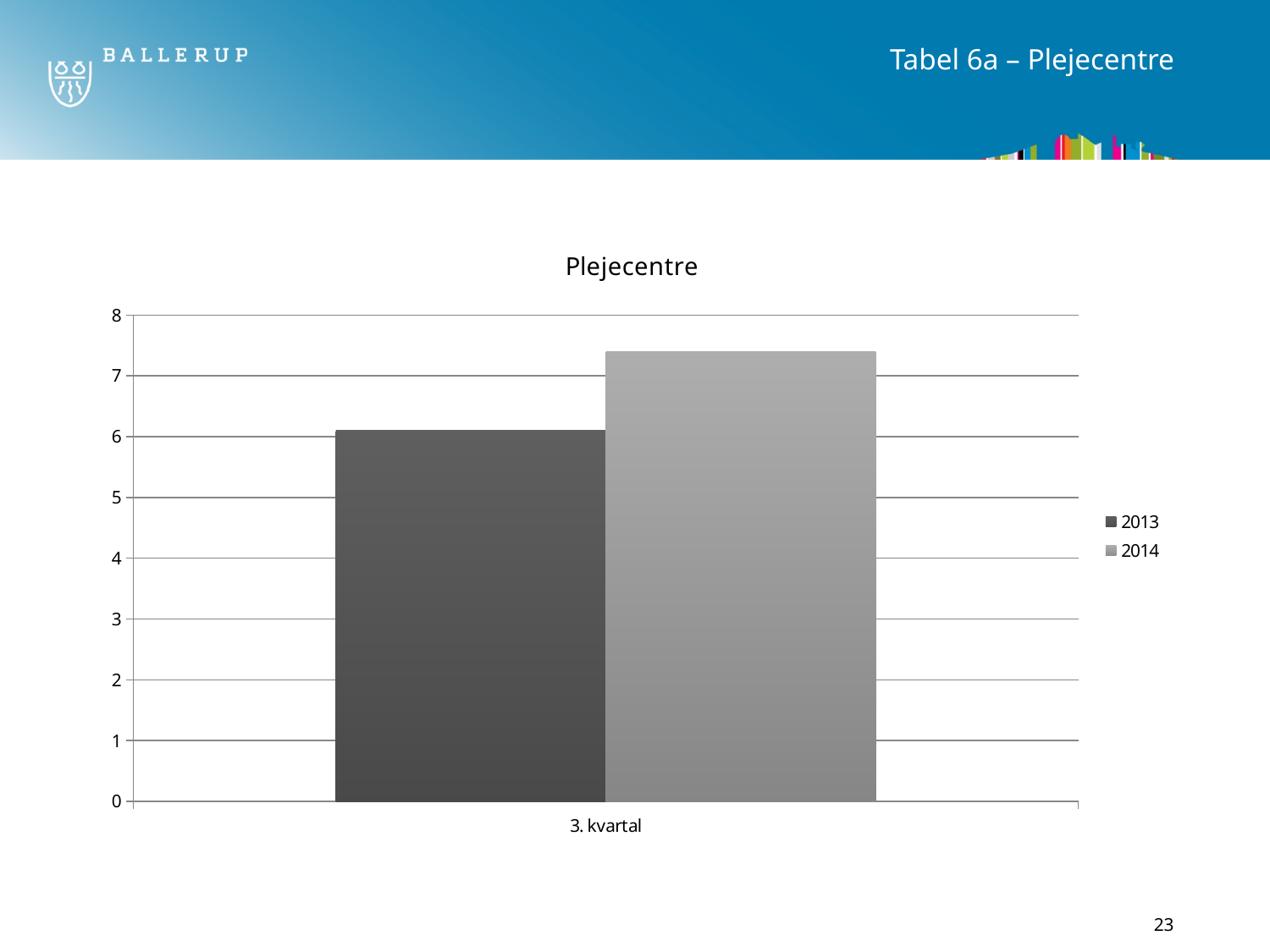
What kind of chart is shown on the slide? bar chart Is the value for 2013 in 3. kvartal greater or less than 5? greater Is the value for 2014 in 3. kvartal greater or less than 7? greater What is the category label shown on the x axis? 3. kvartal Is the value for 2013 in 3. kvartal greater or less than 7? less How many categories are shown on the x axis? 1 Which series has the higher value for 3. kvartal, 2013 or 2014? 2014 Which series has the lowest bar in the chart? 2013 What is the title of the chart? Plejecentre How many series does the legend list? 2 Which series has the highest bar in the chart? 2014